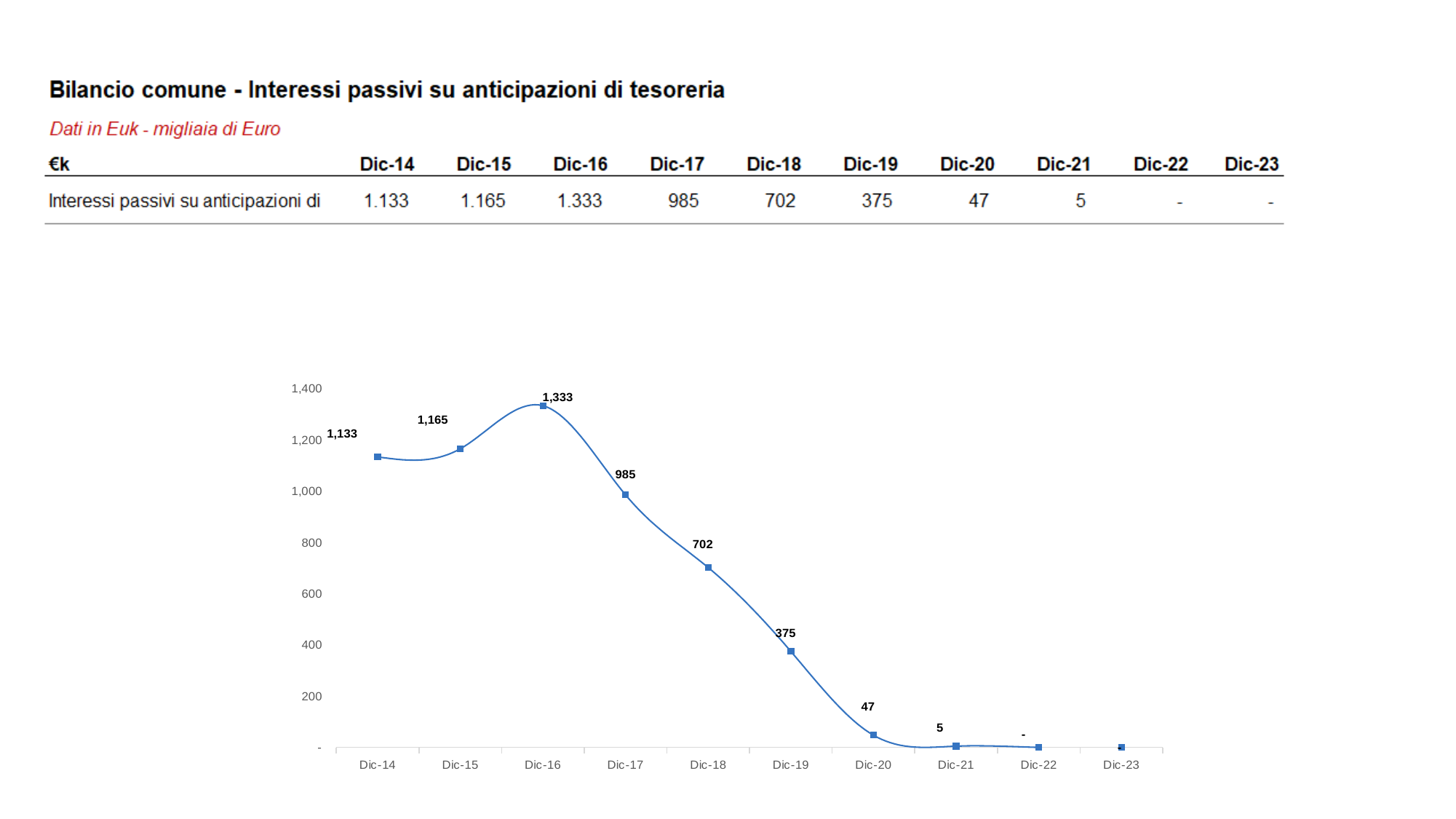
Which is larger, the value for Dic-14 or the value for Dic-15? Dic-15 What is the difference between the values for Dic-18 and Dic-19? 327 Which period has the highest value on the chart? Dic-16 How many periods are shown on the x axis of the chart? 10 What is the value plotted for Dic-20? 47 What is the value plotted for Dic-18? 702 What is the value plotted for Dic-16? 1,333 From Dic-16 to Dic-21, do the values rise or fall along the x axis? fall Is the value for Dic-17 greater or less than 1,000? less Among the periods with a numeric data label, which has the lowest value? Dic-21 What is the difference between the values for Dic-16 and Dic-17? 348 What type of chart is shown on the slide? line chart